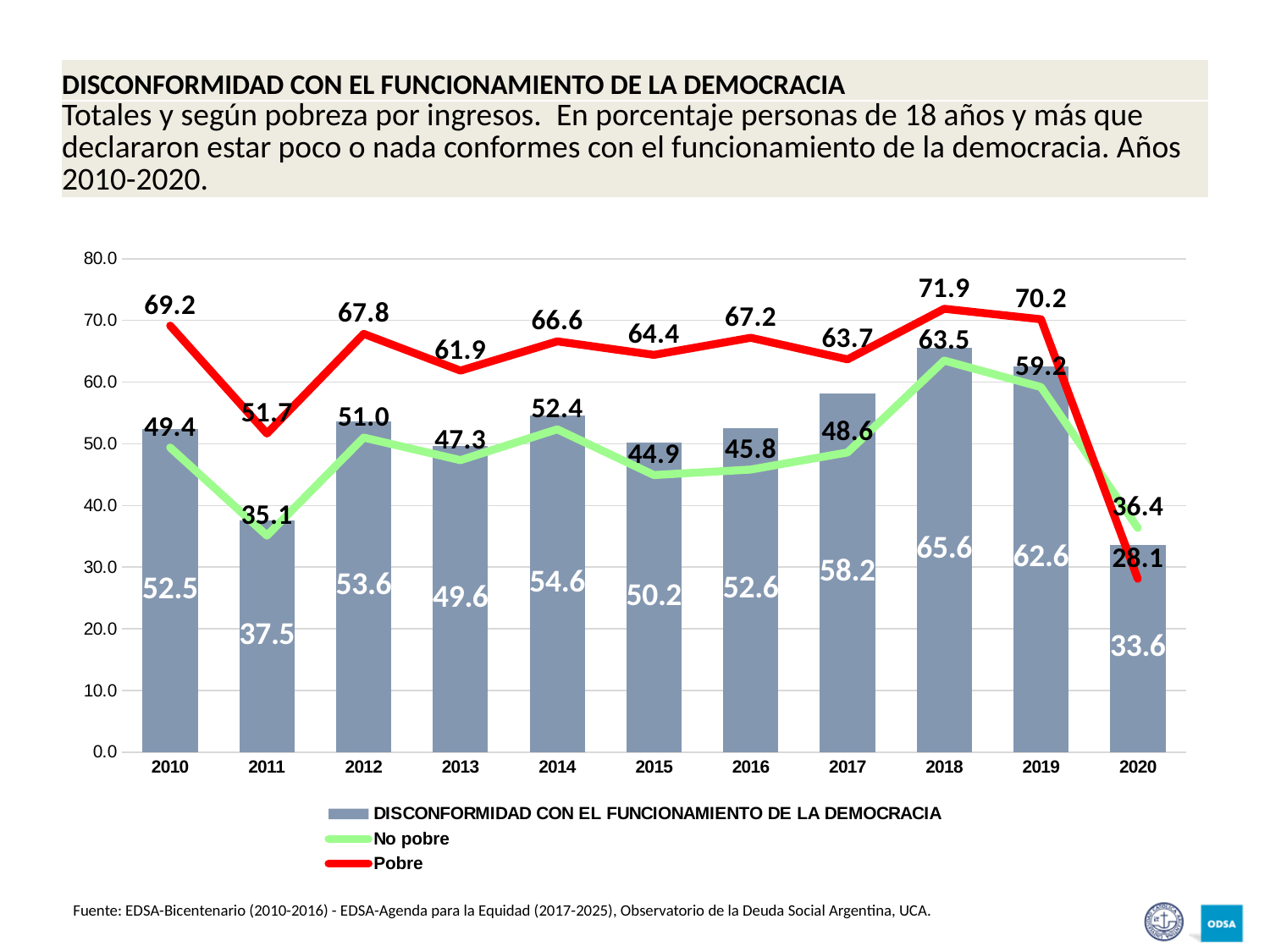
Is the value of the bar series for 2019 greater or less than 60.0? greater What colour is the Pobre line? Red In which year is the bar series (total) lowest? 2020 Which is larger in 2020, the Pobre value or the No pobre value? No pobre In which year is the Pobre series highest? 2018 How many series does the legend list? 3 How many years are shown on the x axis? 11 What is the value of the Pobre series for 2010? 69.2 What is the value of the bar series (DISCONFORMIDAD CON EL FUNCIONAMIENTO DE LA DEMOCRACIA) for 2018? 65.6 What kind of chart is shown on the slide? Combined bar and line chart What is the value of the No pobre series for 2015? 44.9 What is the difference between the Pobre and No pobre values in 2011? 16.6